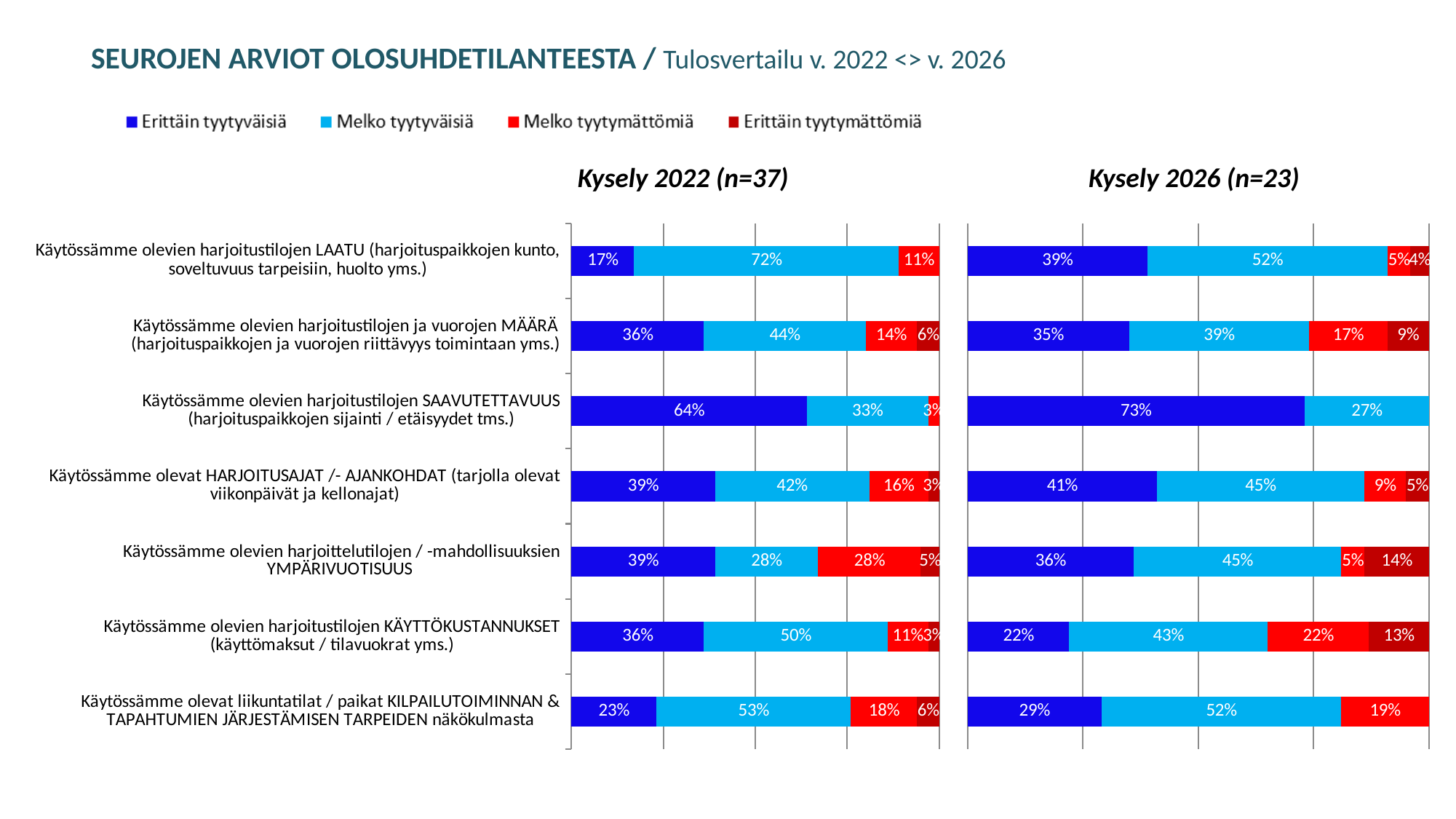
How many series does the legend list? 4 How many categories are shown in the Kysely 2022 (n=37) chart? 7 In the Kysely 2022 (n=37) chart, what is the 'Melko tyytyväisiä' value for the LAATU category? 72% Which is larger: the 'Melko tyytymättömiä' value for KÄYTTÖKUSTANNUKSET in the Kysely 2022 chart or in the Kysely 2026 chart? Kysely 2026 In the Kysely 2022 (n=37) chart, what is the difference between the 'Melko tyytyväisiä' and 'Erittäin tyytyväisiä' values for the KILPAILUTOIMINNAN category? 30% What kind of chart is the Kysely 2026 (n=23) chart? Stacked bar chart In the Kysely 2026 (n=23) chart, which category has the lowest 'Erittäin tyytyväisiä' value? KÄYTTÖKUSTANNUKSET Which legend entry is shown in dark red? Erittäin tyytymättömiä In the Kysely 2026 (n=23) chart, what is the 'Erittäin tyytyväisiä' value for the SAAVUTETTAVUUS category? 73% In the Kysely 2022 (n=37) chart, what is the combined share of 'Erittäin tyytyväisiä' and 'Melko tyytyväisiä' for the MÄÄRÄ category? 80% In the Kysely 2026 (n=23) chart, what is the 'Erittäin tyytymättömiä' value for the YMPÄRIVUOTISUUS category? 14% In the Kysely 2022 (n=37) chart, which category has the highest 'Erittäin tyytyväisiä' value? SAAVUTETTAVUUS